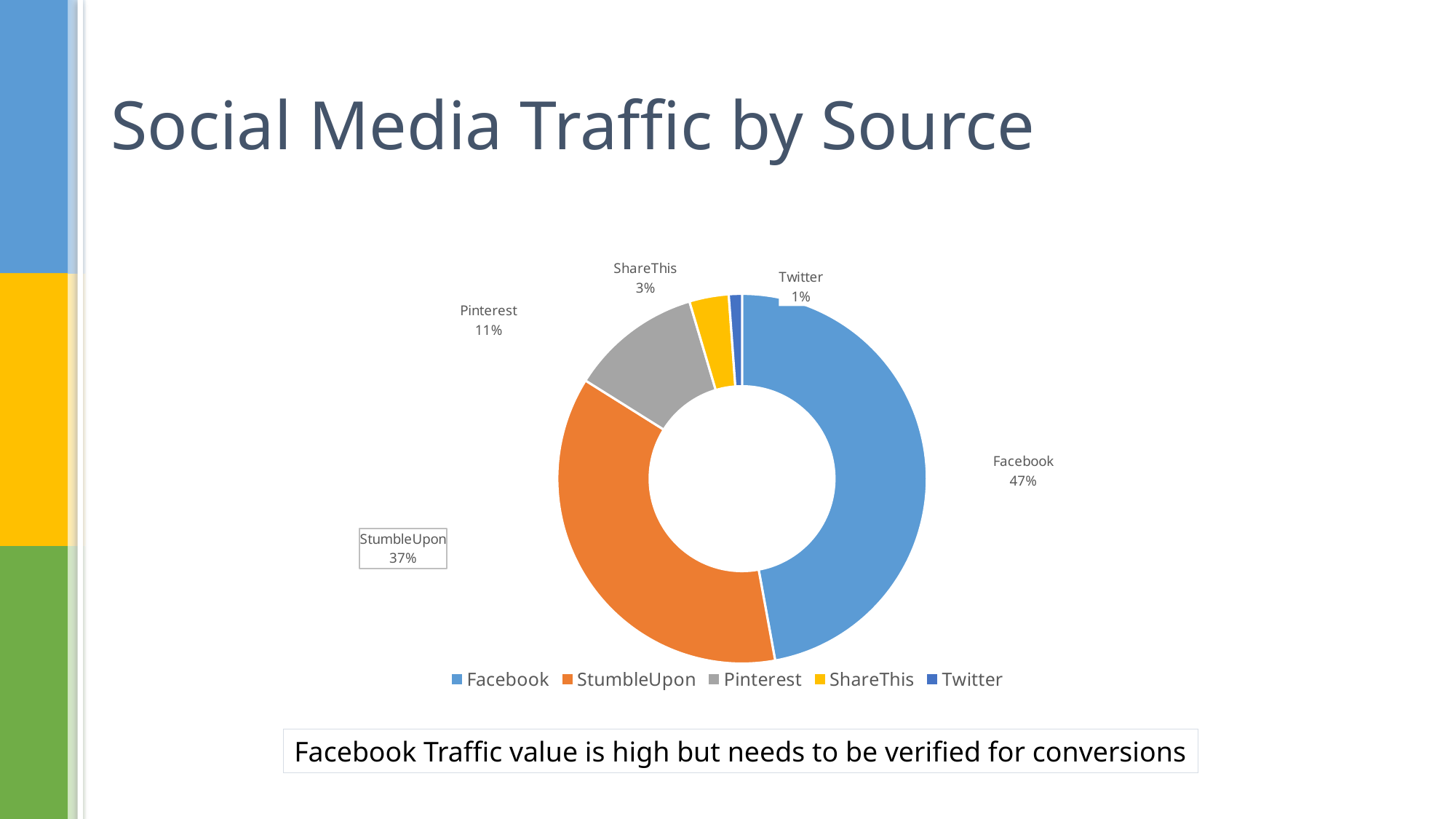
What share of social media traffic comes from Facebook? 47% What share of social media traffic comes from ShareThis? 3% What colour represents StumbleUpon in the chart? Orange What kind of chart is shown on the slide? Doughnut (pie) chart What is the difference in percentage points between the Facebook and StumbleUpon shares? 10 What share of social media traffic comes from StumbleUpon? 37% How many traffic sources are shown in the chart? 5 Which source has the largest share of social media traffic? Facebook Which has a larger share of traffic, Pinterest or ShareThis? Pinterest Which source has the smallest share of social media traffic? Twitter